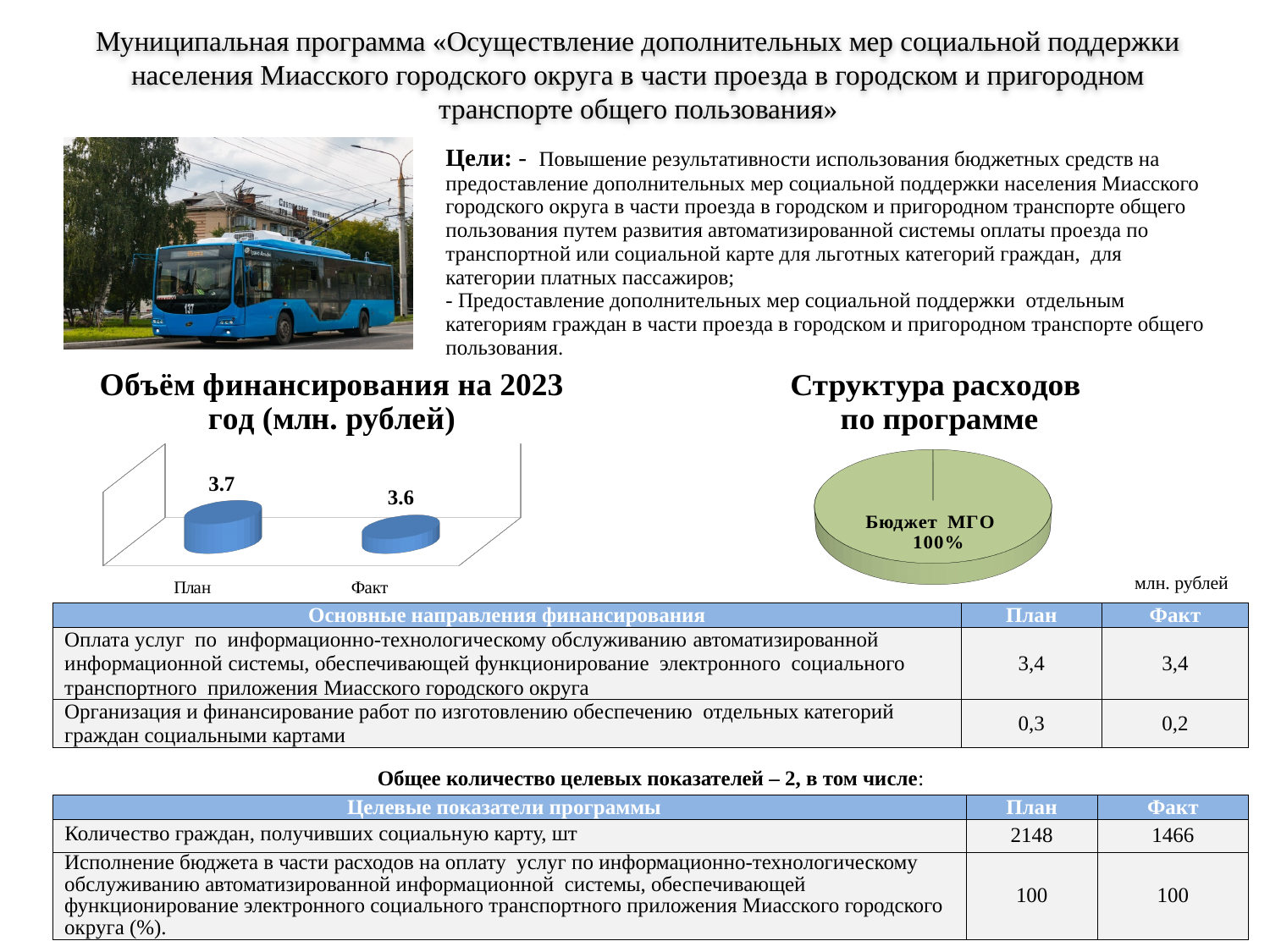
What kind of chart is "Структура расходов по программе"? pie chart In the chart "Объём финансирования на 2023 год (млн. рублей)", which category has the higher value? План In the chart "Объём финансирования на 2023 год (млн. рублей)", which category has the lower value? Факт In the chart "Объём финансирования на 2023 год (млн. рублей)", what is the value for Факт? 3.6 What kind of chart is "Объём финансирования на 2023 год (млн. рублей)"? bar chart How many categories are shown in the chart "Объём финансирования на 2023 год (млн. рублей)"? 2 In the chart "Объём финансирования на 2023 год (млн. рублей)", is the value for План larger or smaller than the value for Факт? larger In the chart "Структура расходов по программе", what share does Бюджет МГО have? 100% What is the title of the chart on the right side of the slide? Структура расходов по программе In the chart "Объём финансирования на 2023 год (млн. рублей)", what is the value for План? 3.7 In the chart "Объём финансирования на 2023 год (млн. рублей)", what is the difference between План and Факт? 0.1 How many slices does the pie chart "Структура расходов по программе" have? 1